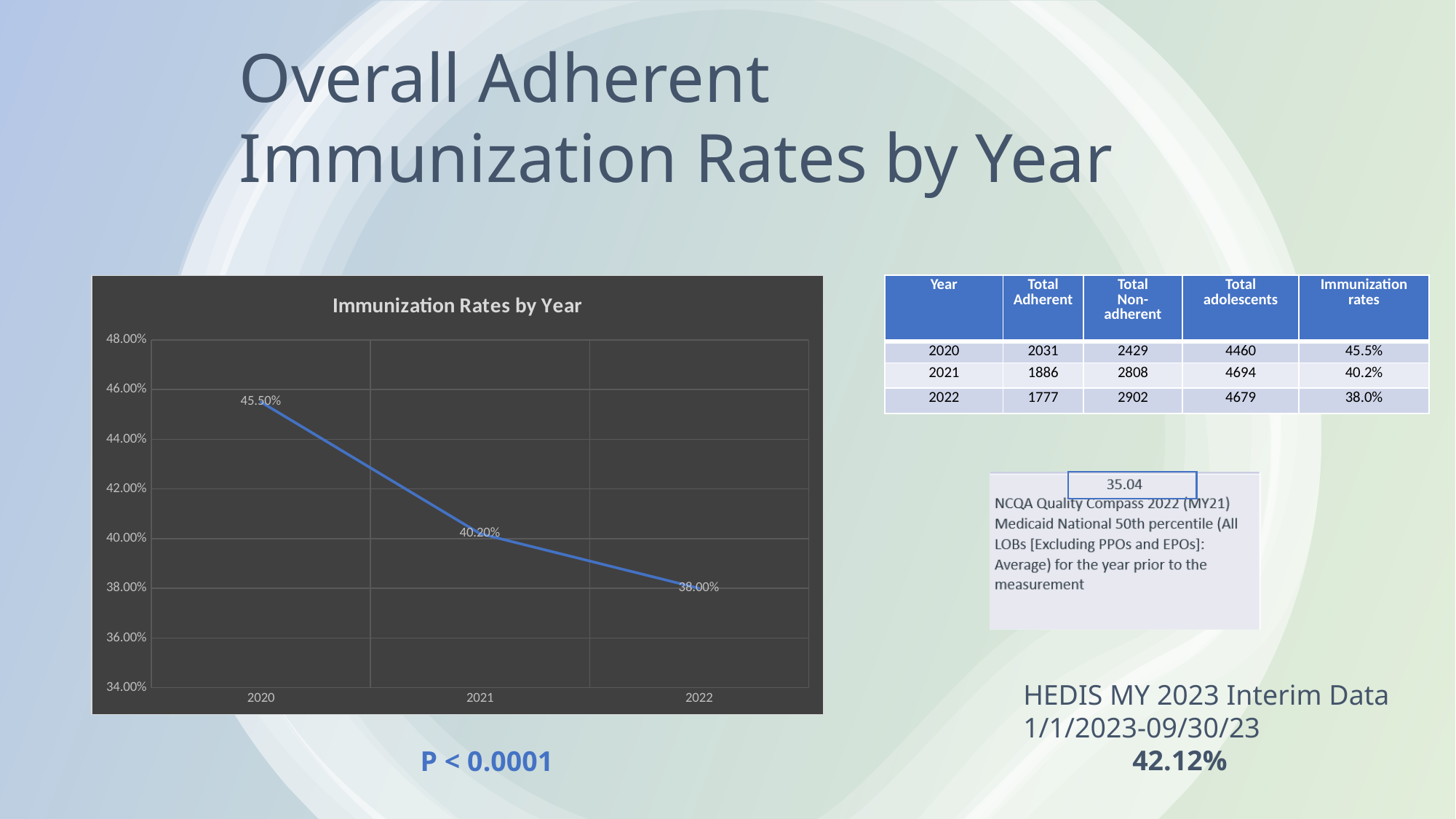
Which year has a higher immunization rate, 2021 or 2022? 2021 What kind of chart is shown on the slide? line chart What is the difference between the immunization rates for 2020 and 2021? 5.30% What is the immunization rate for 2021 in the chart? 40.20% Which year has the lowest immunization rate in the chart? 2022 What is the immunization rate for 2020 in the chart? 45.50% Which year has the highest immunization rate in the chart? 2020 What is the difference between the immunization rates for 2020 and 2022? 7.50% Do the immunization rates rise or fall from 2020 to 2022? fall What is the immunization rate for 2022 in the chart? 38.00% How many years are plotted in the chart? 3 Is the immunization rate for 2021 greater or less than 42.00%? less